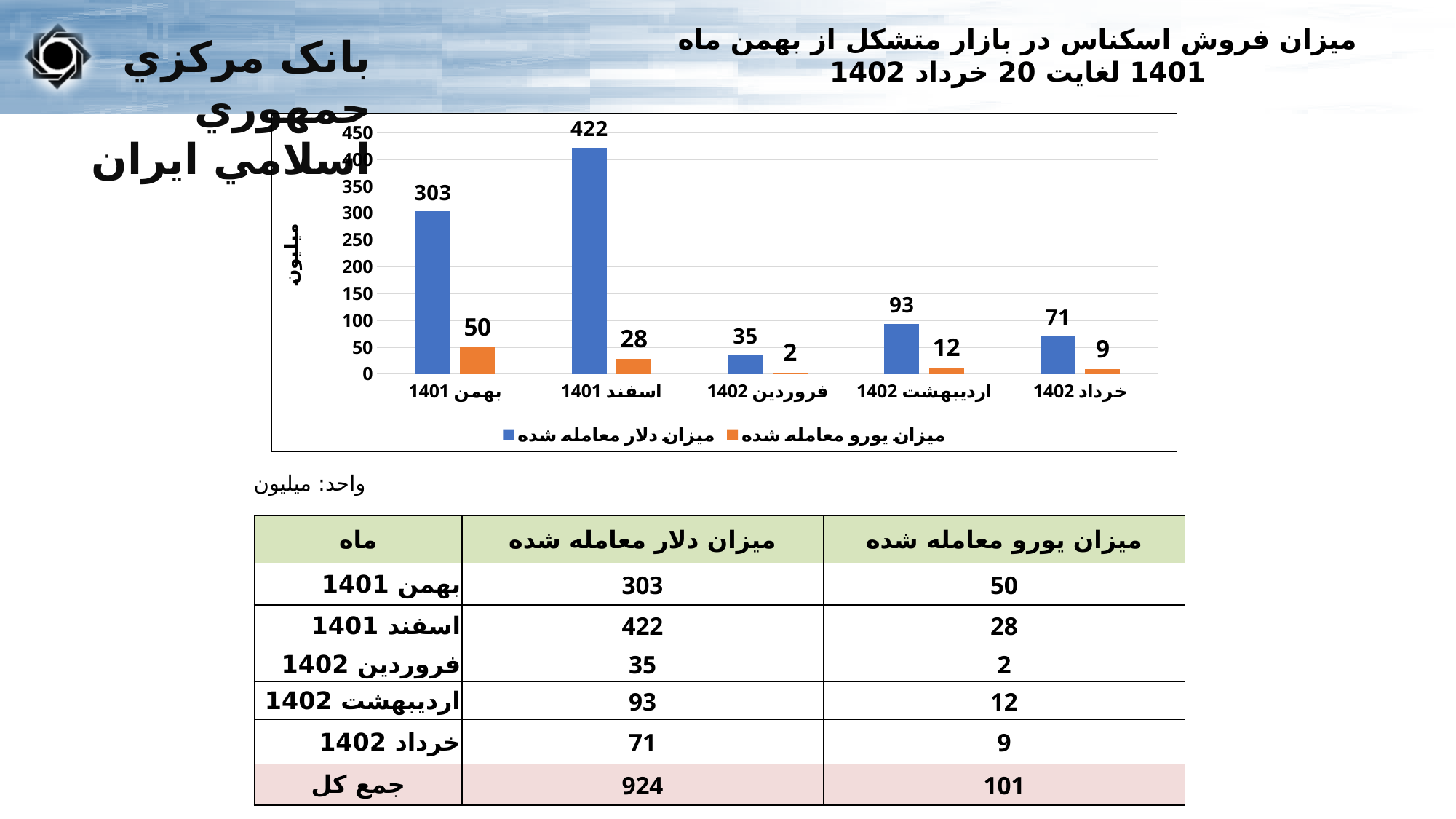
Which is larger: میزان دلار معامله شده for اردیبهشت 1402 or for خرداد 1402? اردیبهشت 1402 Which colour represents میزان یورو معامله شده in the chart? orange How many months are shown on the x axis of the chart? 5 What is the value of میزان یورو معامله شده for بهمن 1401? 50 How many series does the chart legend list? 2 Is the value of میزان دلار معامله شده for فروردین 1402 greater or less than 50? less What is the value of میزان دلار معامله شده for خرداد 1402? 71 Which month has the lowest value for میزان یورو معامله شده? فروردین 1402 What is the difference between میزان دلار معامله شده for اسفند 1401 and بهمن 1401? 119 What is the value of میزان دلار معامله شده for اسفند 1401? 422 What kind of chart is shown on the slide? bar chart Which month has the highest value for میزان دلار معامله شده? اسفند 1401